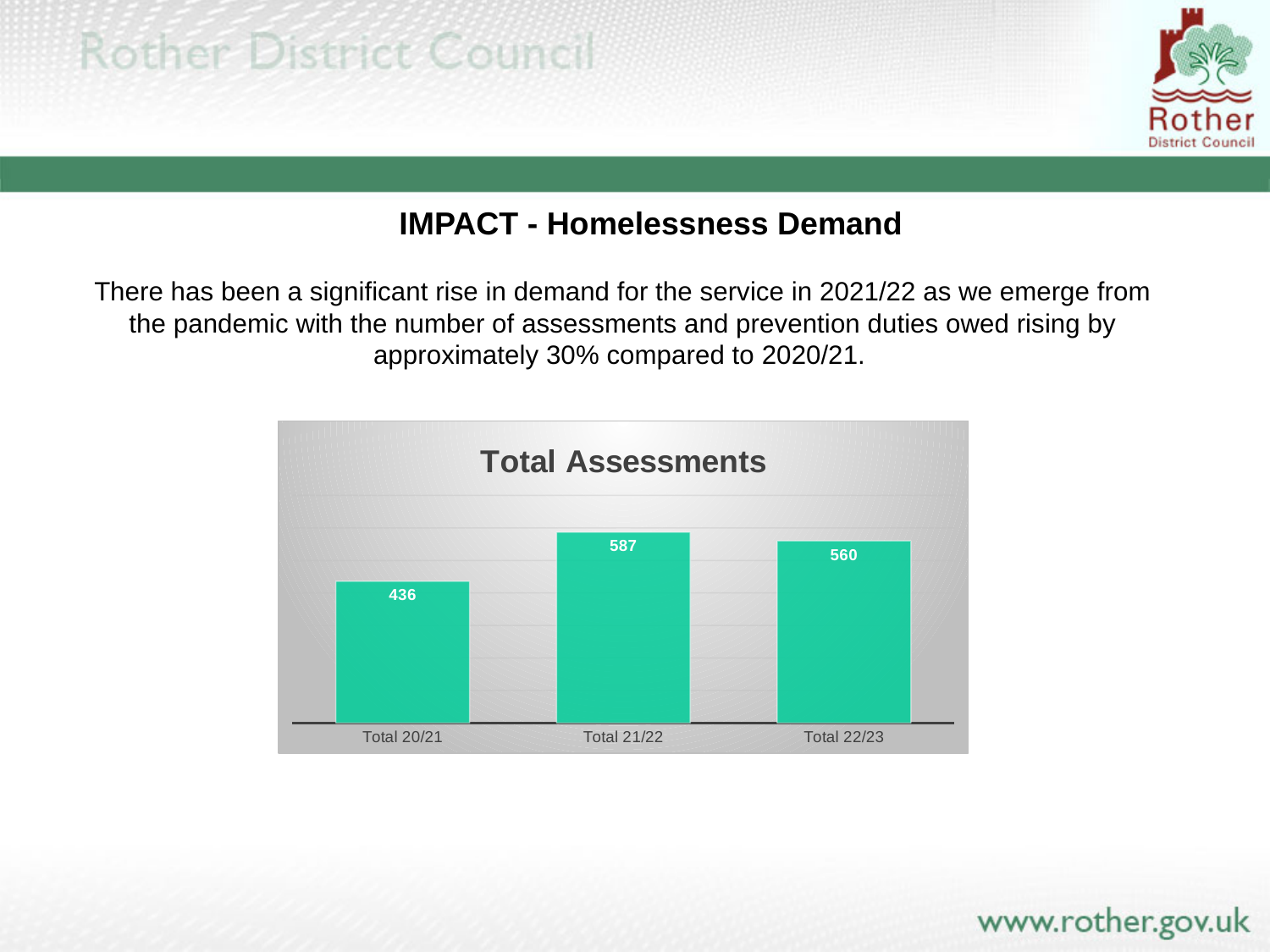
What is the value for Total 22/23 in the Total Assessments chart? 560 What is the title of the chart on the slide? Total Assessments What is the difference between the values for Total 21/22 and Total 22/23? 27 What is the value for Total 21/22 in the Total Assessments chart? 587 Which category has the highest value in the Total Assessments chart? Total 21/22 Which is larger, the value for Total 22/23 or the value for Total 20/21? Total 22/23 What is the value for Total 20/21 in the Total Assessments chart? 436 What kind of chart is the Total Assessments chart? Bar chart Does the value rise or fall from Total 20/21 to Total 21/22? Rise How many categories are shown in the Total Assessments chart? 3 What is the difference between the values for Total 21/22 and Total 20/21? 151 Which category has the lowest value in the Total Assessments chart? Total 20/21